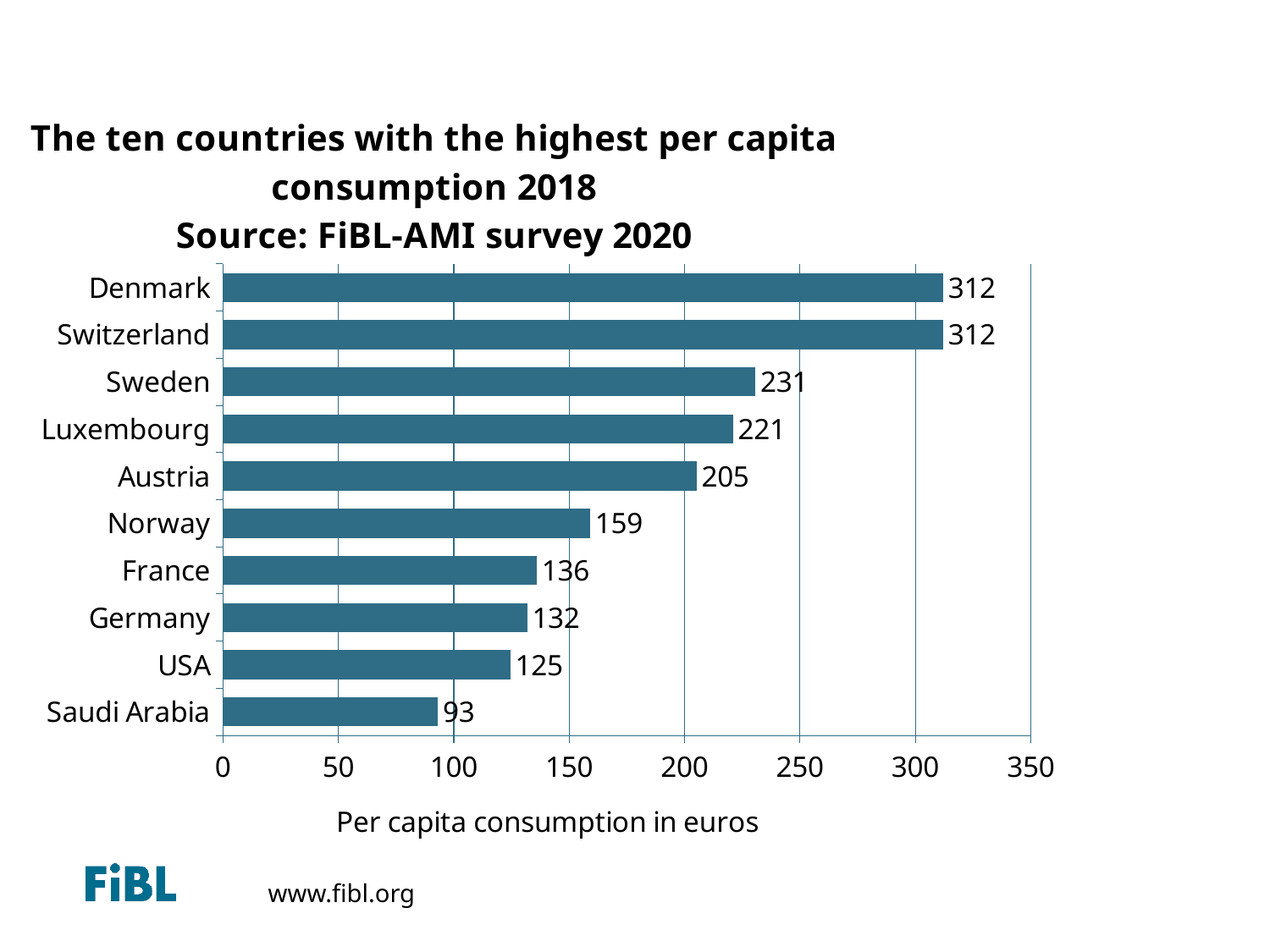
Which has a higher per capita consumption, Austria or Norway? Austria What is the per capita consumption for Norway? 159 What is the difference in per capita consumption between France and Germany? 4 What source is given in the chart title? FiBL-AMI survey 2020 What kind of chart is shown on the slide? Bar chart What is the label of the horizontal axis? Per capita consumption in euros Is the value for Luxembourg greater or less than 200? greater Which country has the lowest per capita consumption? Saudi Arabia How many countries are shown in the chart? 10 What is the per capita consumption for Saudi Arabia? 93 What is the per capita consumption for Sweden? 231 What is the difference in per capita consumption between Denmark and Sweden? 81